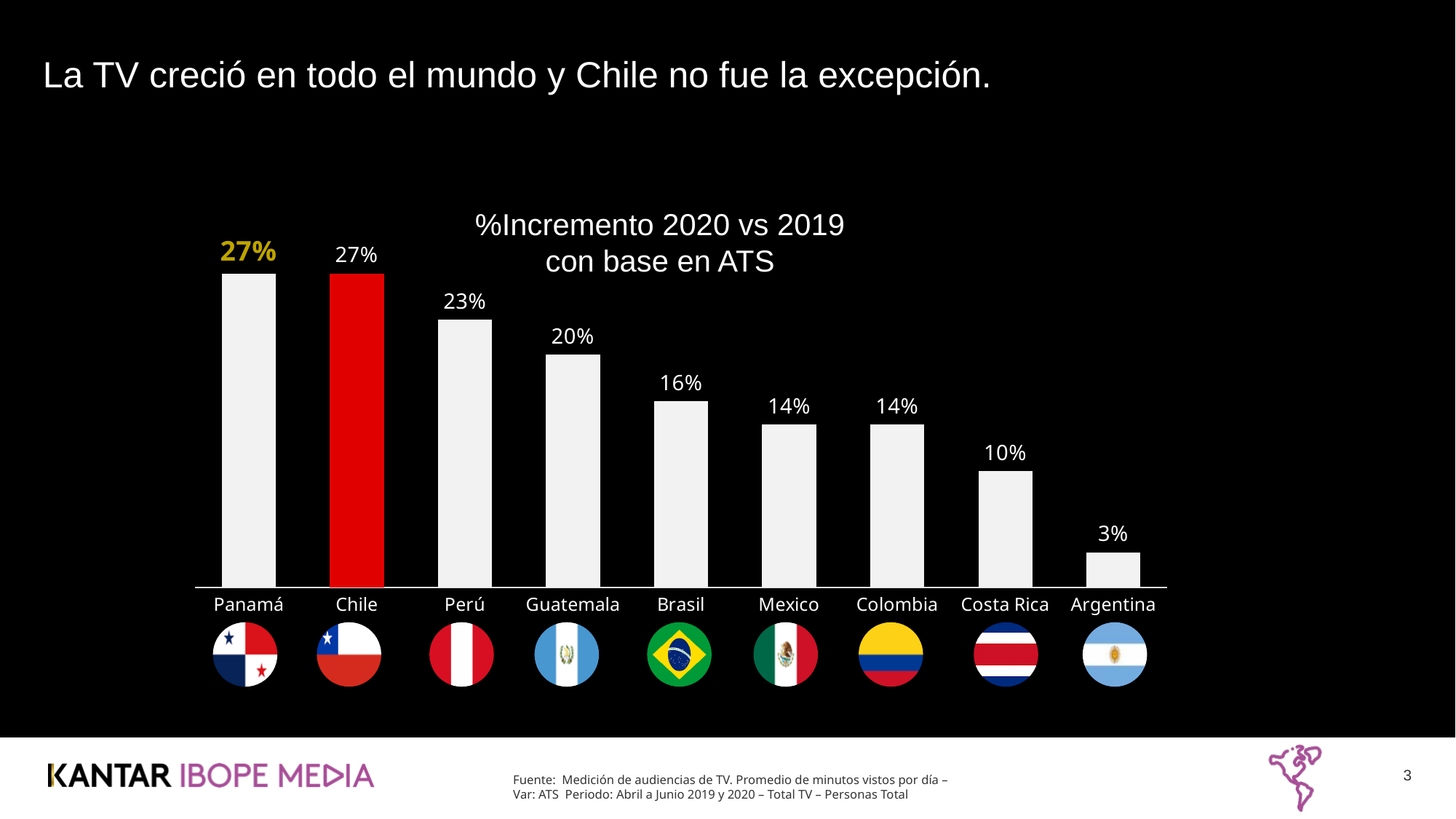
Which is larger, the value for Guatemala or the value for Brasil? Guatemala What is the value for Argentina? 3% Do the values rise or fall from left to right along the x axis? Fall What is the difference between the values for Perú and Guatemala? 3% Which country has the lowest value? Argentina Which country's bar is coloured red? Chile What is the value for Perú? 23% What is the difference between the values for Panamá and Argentina? 24% What is the value for Brasil? 16% How many countries are shown in the chart? 9 What is the value for Costa Rica? 10% What kind of chart is shown? Bar chart